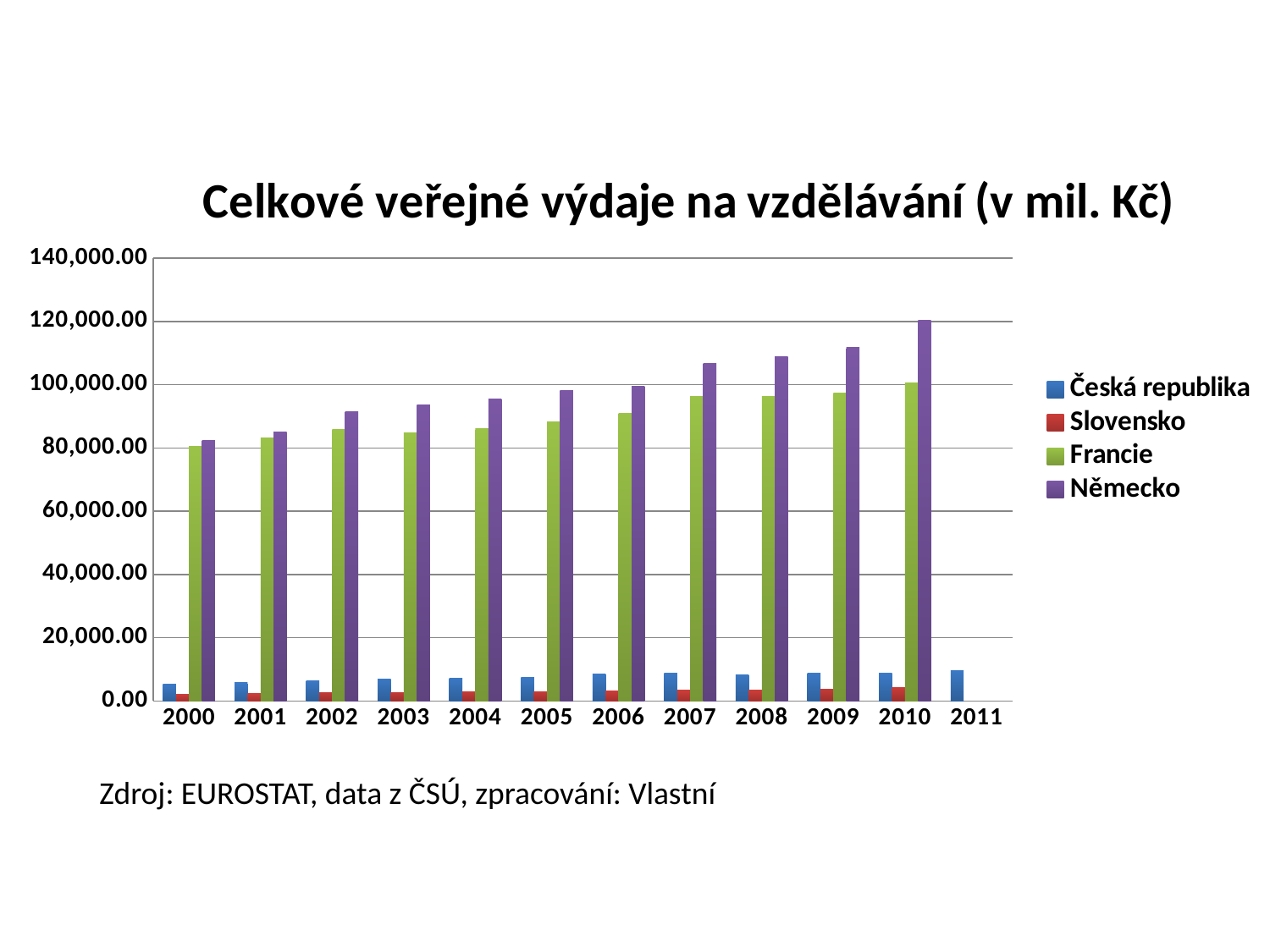
Is the value for Německo in 2010 greater or less than 100,000.00? greater How many years are shown on the x axis? 12 Which series has the lowest value in 2005? Slovensko Is the value for Česká republika in 2011 greater or less than 20,000.00? less Which is larger in 2008, the value for Německo or the value for Francie? Německo What is the title of the chart? Celkové veřejné výdaje na vzdělávání (v mil. Kč) How many series does the legend list? 4 Which series has the highest value in 2010? Německo Which is larger in 2005, the value for Česká republika or the value for Slovensko? Česká republika Is the value for Francie in 2000 greater or less than 100,000.00? less What kind of chart is shown on the slide? bar chart Do the values for Německo rise or fall from 2000 to 2010? rise